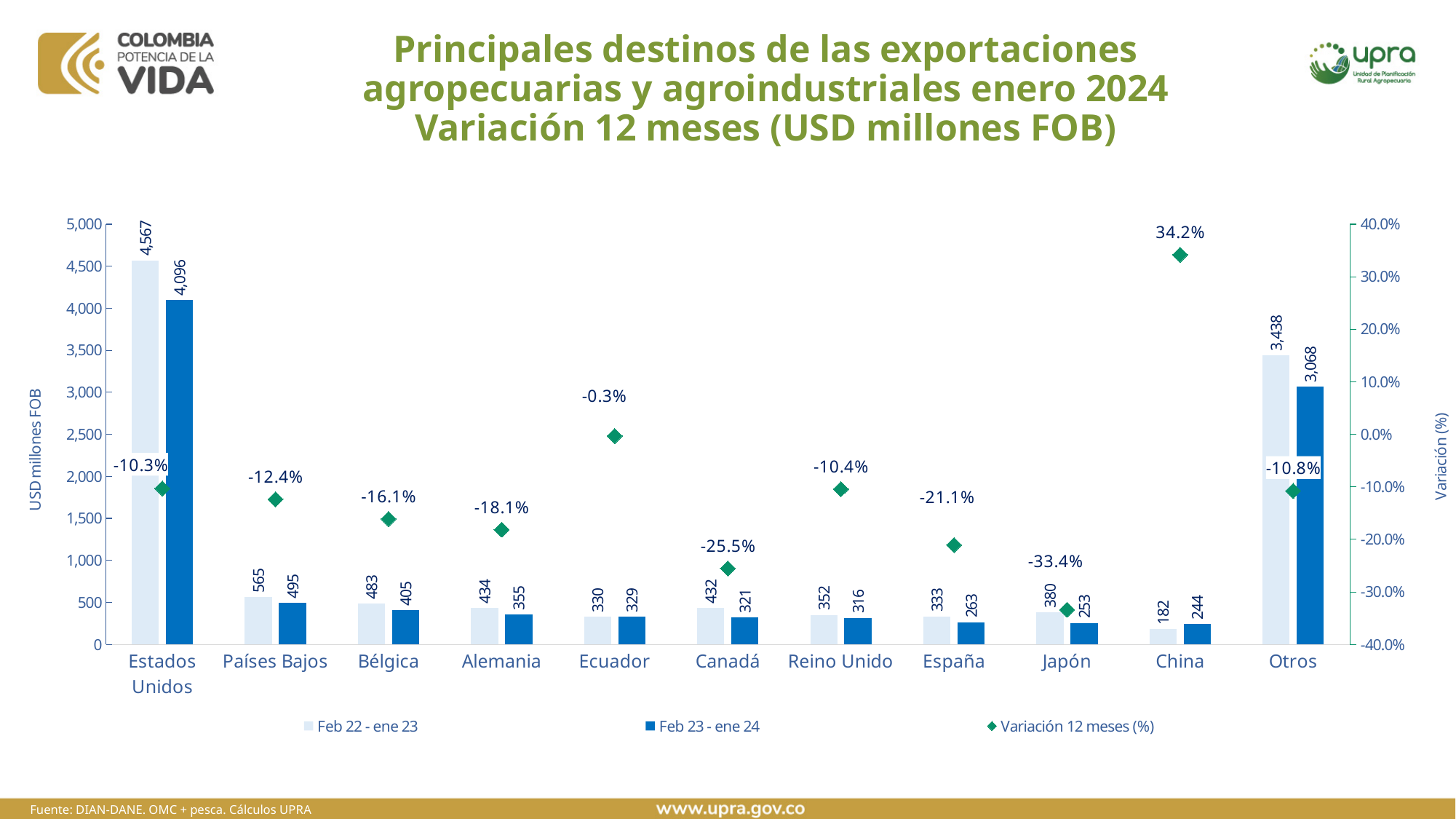
How many destination categories are shown on the x axis? 11 Which country has the lowest Variación 12 meses (%)? Japón What is the difference between the Feb 22 - ene 23 and Feb 23 - ene 24 values for Canadá? 111 What is the label of the right-hand vertical axis? Variación (%) What is the value for Japón in the Feb 22 - ene 23 series? 380 How many series does the legend list? 3 Which country has the highest Variación 12 meses (%)? China What is the value for Estados Unidos in the Feb 23 - ene 24 series? 4,096 What kind of chart is used for the Feb 22 - ene 23 and Feb 23 - ene 24 series? Bar chart What is the Variación 12 meses (%) value for China? 34.2% Which is larger for China: the Feb 22 - ene 23 value or the Feb 23 - ene 24 value? Feb 23 - ene 24 Which category has the lowest value in the Feb 22 - ene 23 series? China